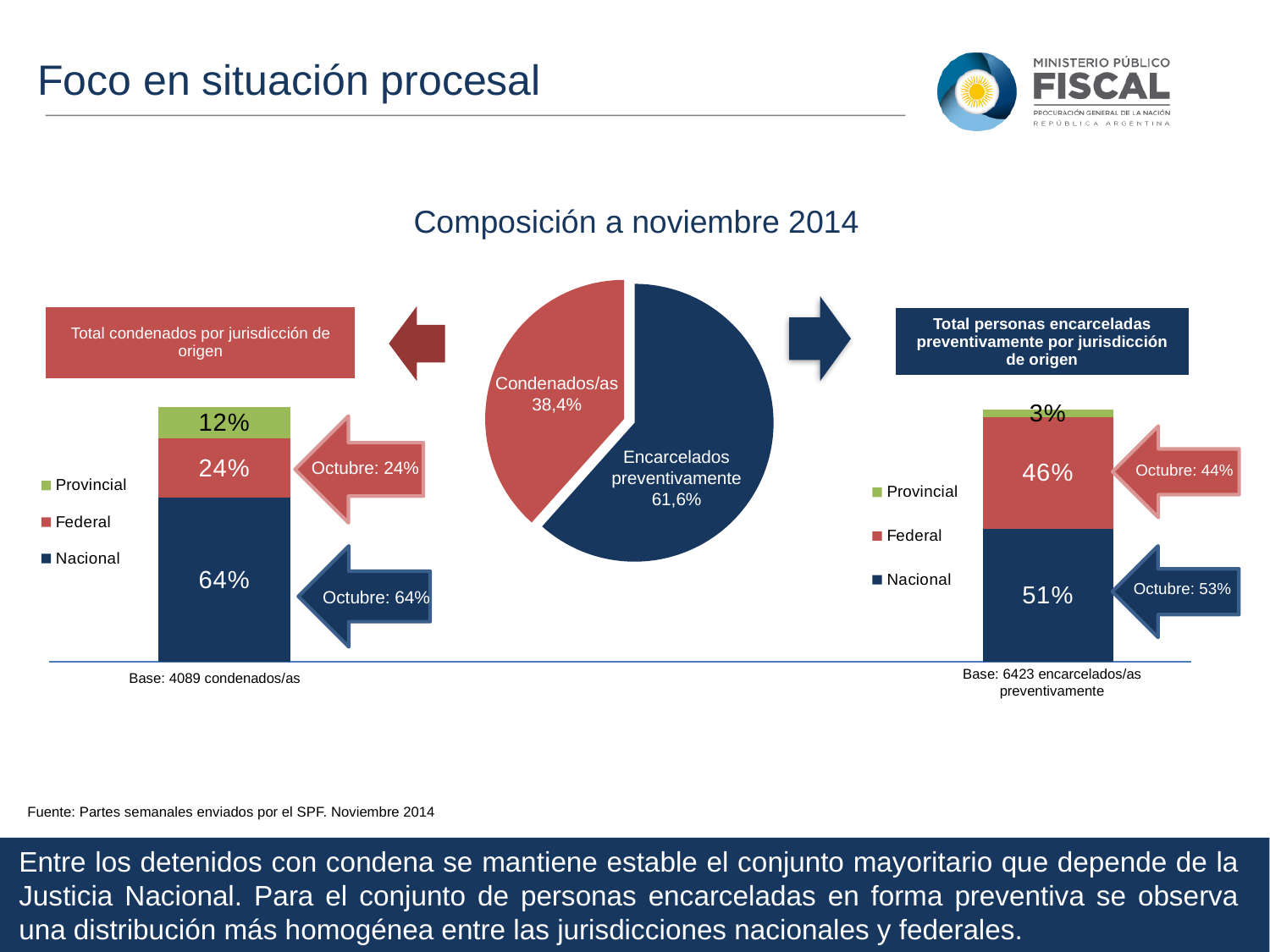
How many series does the legend list for the chart titled 'Total personas encarceladas preventivamente por jurisdicción de origen'? 3 In the chart titled 'Total condenados por jurisdicción de origen', what is the value for Nacional? 64% In the chart titled 'Total condenados por jurisdicción de origen', what is the value for Federal? 24% In the chart titled 'Total condenados por jurisdicción de origen', what is the value for Provincial? 12% In the pie chart in the centre of the slide, what share is labelled for Condenados/as? 38,4% In the chart titled 'Total condenados por jurisdicción de origen', which jurisdiction has the lowest value? Provincial In the chart titled 'Total personas encarceladas preventivamente por jurisdicción de origen', which jurisdiction has the highest value? Nacional In the pie chart in the centre of the slide, what share is labelled for Encarcelados preventivamente? 61,6% In the chart titled 'Total condenados por jurisdicción de origen', what is the difference between the Nacional and Federal values? 40% In the pie chart in the centre of the slide, which slice is larger, Condenados/as or Encarcelados preventivamente? Encarcelados preventivamente In the chart titled 'Total personas encarceladas preventivamente por jurisdicción de origen', what is the value for Nacional? 51% In the chart titled 'Total personas encarceladas preventivamente por jurisdicción de origen', what is the value for Federal? 46%